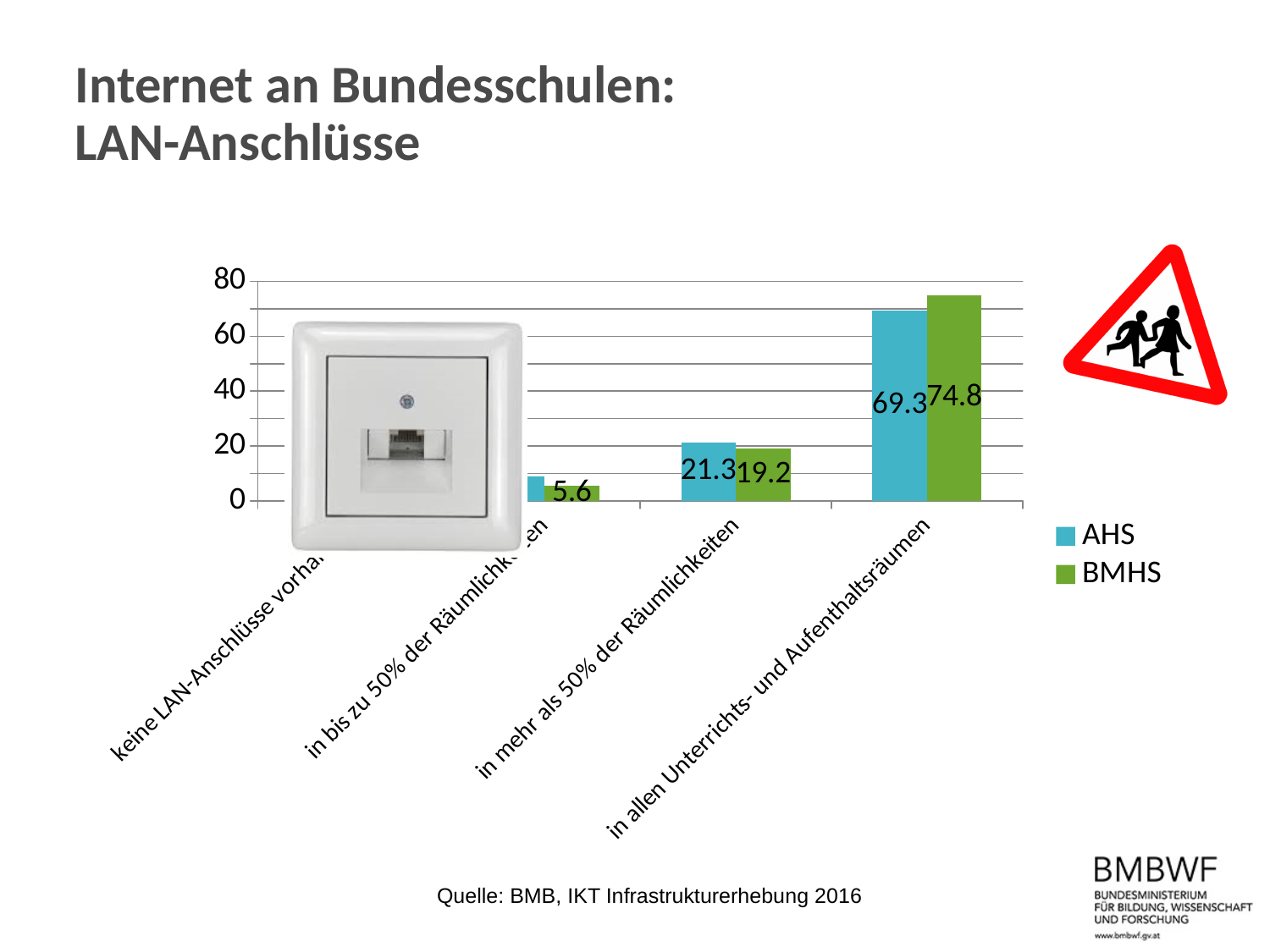
For "in allen Unterrichts- und Aufenthaltsräumen", which series has the larger value, AHS or BMHS? BMHS What is the BMHS value for "in bis zu 50% der Räumlichkeiten"? 5.6 What kind of chart is shown on the slide? bar chart What is the difference between the AHS and BMHS values for "in mehr als 50% der Räumlichkeiten"? 2.1 What is the AHS value for "in allen Unterrichts- und Aufenthaltsräumen"? 69.3 Which category has the highest BMHS value? in allen Unterrichts- und Aufenthaltsräumen What is the difference between the BMHS and AHS values for "in allen Unterrichts- und Aufenthaltsräumen"? 5.5 What is the AHS value for "in mehr als 50% der Räumlichkeiten"? 21.3 What is the BMHS value for "in mehr als 50% der Räumlichkeiten"? 19.2 For "in mehr als 50% der Räumlichkeiten", which series has the larger value, AHS or BMHS? AHS What is the BMHS value for "in allen Unterrichts- und Aufenthaltsräumen"? 74.8 How many series does the legend list? 2